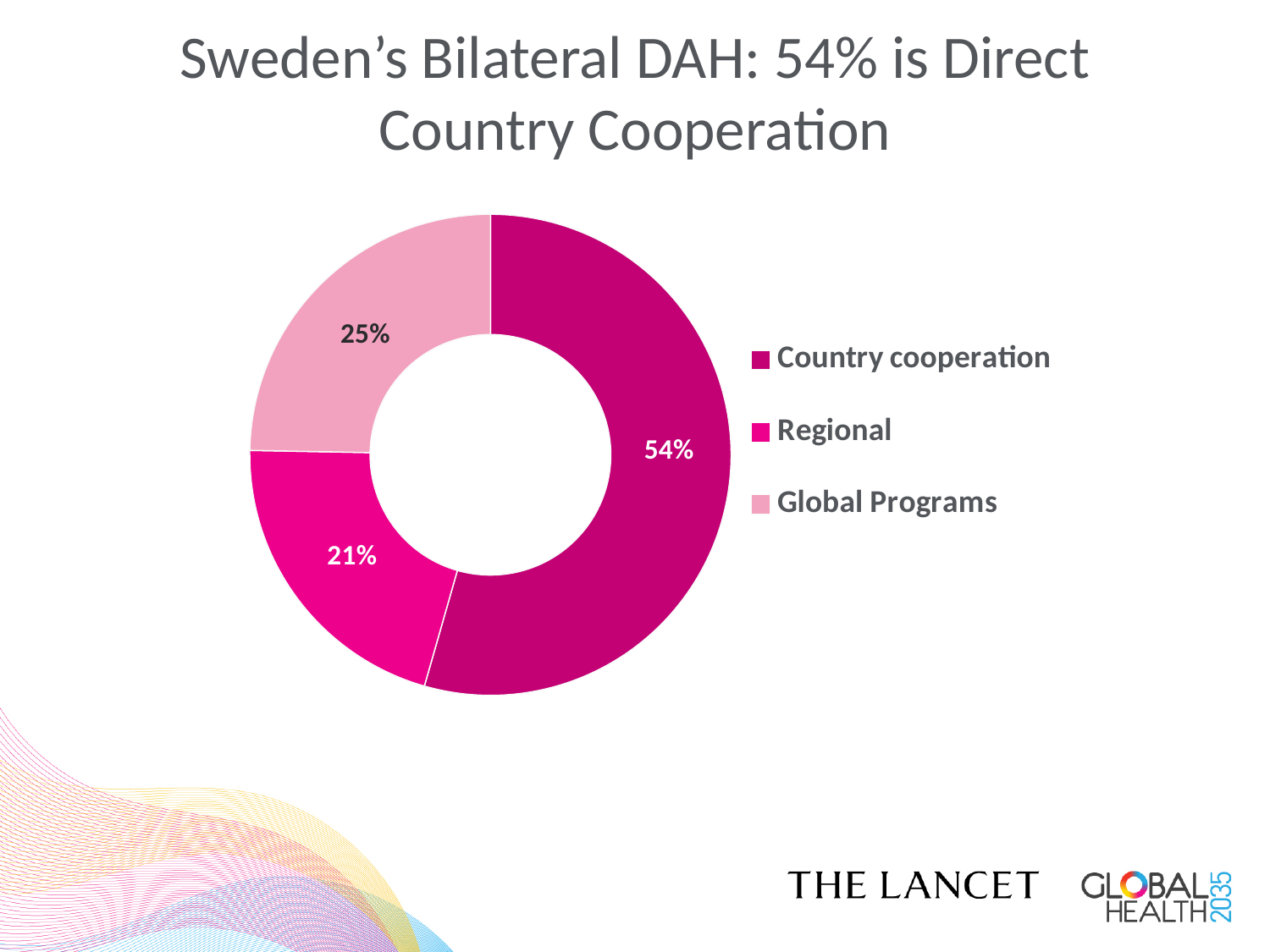
What kind of chart is shown on the slide? Pie chart (doughnut) What is the difference in percentage points between the Country cooperation share and the Global Programs share? 29 What share of Sweden's bilateral DAH goes to Country cooperation? 54% Which category has the largest share of Sweden's bilateral DAH? Country cooperation What is the title of the slide? Sweden's Bilateral DAH: 54% is Direct Country Cooperation Which legend entry is shown in the lightest pink colour? Global Programs What is the difference in percentage points between the Global Programs share and the Regional share? 4 What share of Sweden's bilateral DAH goes to Global Programs? 25% Which category has the smallest share of Sweden's bilateral DAH? Regional Which is larger, the share for Regional or the share for Global Programs? Global Programs How many categories are shown in the chart? 3 What share of Sweden's bilateral DAH goes to Regional? 21%